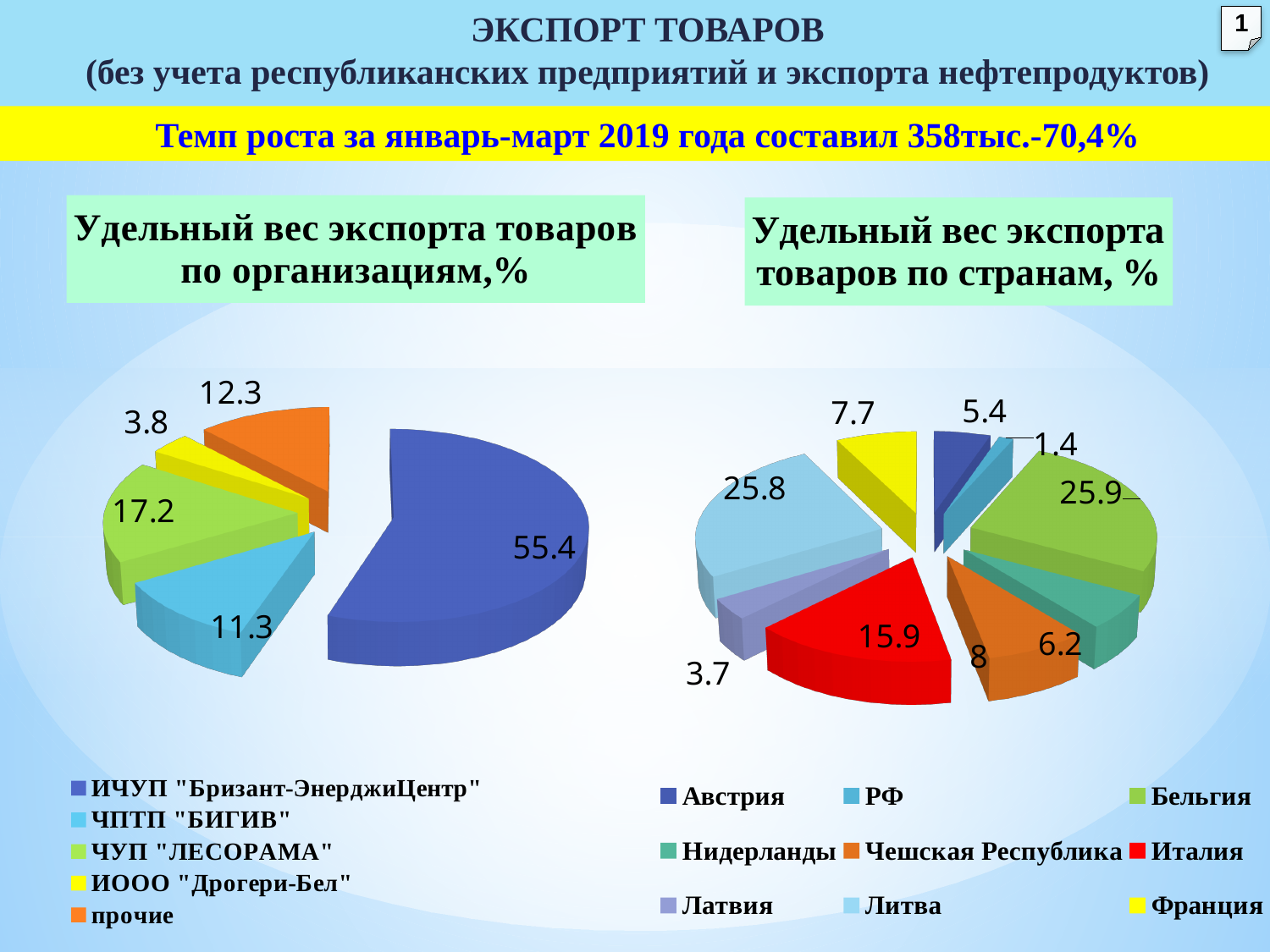
In the chart 'Удельный вес экспорта товаров по организациям,%', what is the value for ЧУП "ЛЕСОРАМА"? 17.2 In the chart 'Удельный вес экспорта товаров по организациям,%', which organization has the smallest share? ИООО "Дрогери-Бел" In the chart 'Удельный вес экспорта товаров по организациям,%', what is the value for ИЧУП "Бризант-ЭнерджиЦентр"? 55.4 In the chart 'Удельный вес экспорта товаров по организациям,%', what is the difference between the values for ЧУП "ЛЕСОРАМА" and ЧПТП "БИГИВ"? 5.9 How many countries does the legend of 'Удельный вес экспорта товаров по странам, %' list? 9 How many categories does the legend of 'Удельный вес экспорта товаров по организациям,%' list? 5 What type of chart is used for 'Удельный вес экспорта товаров по организациям,%'? pie chart In the chart 'Удельный вес экспорта товаров по странам, %', which country has the smallest share? РФ In the chart 'Удельный вес экспорта товаров по странам, %', what is the value for Италия? 15.9 In the chart 'Удельный вес экспорта товаров по странам, %', what is the value for Чешская Республика? 8 In the chart 'Удельный вес экспорта товаров по странам, %', what colour is the slice for Франция? yellow In the chart 'Удельный вес экспорта товаров по странам, %', which is larger, the value for Италия or the value for Нидерланды? Италия